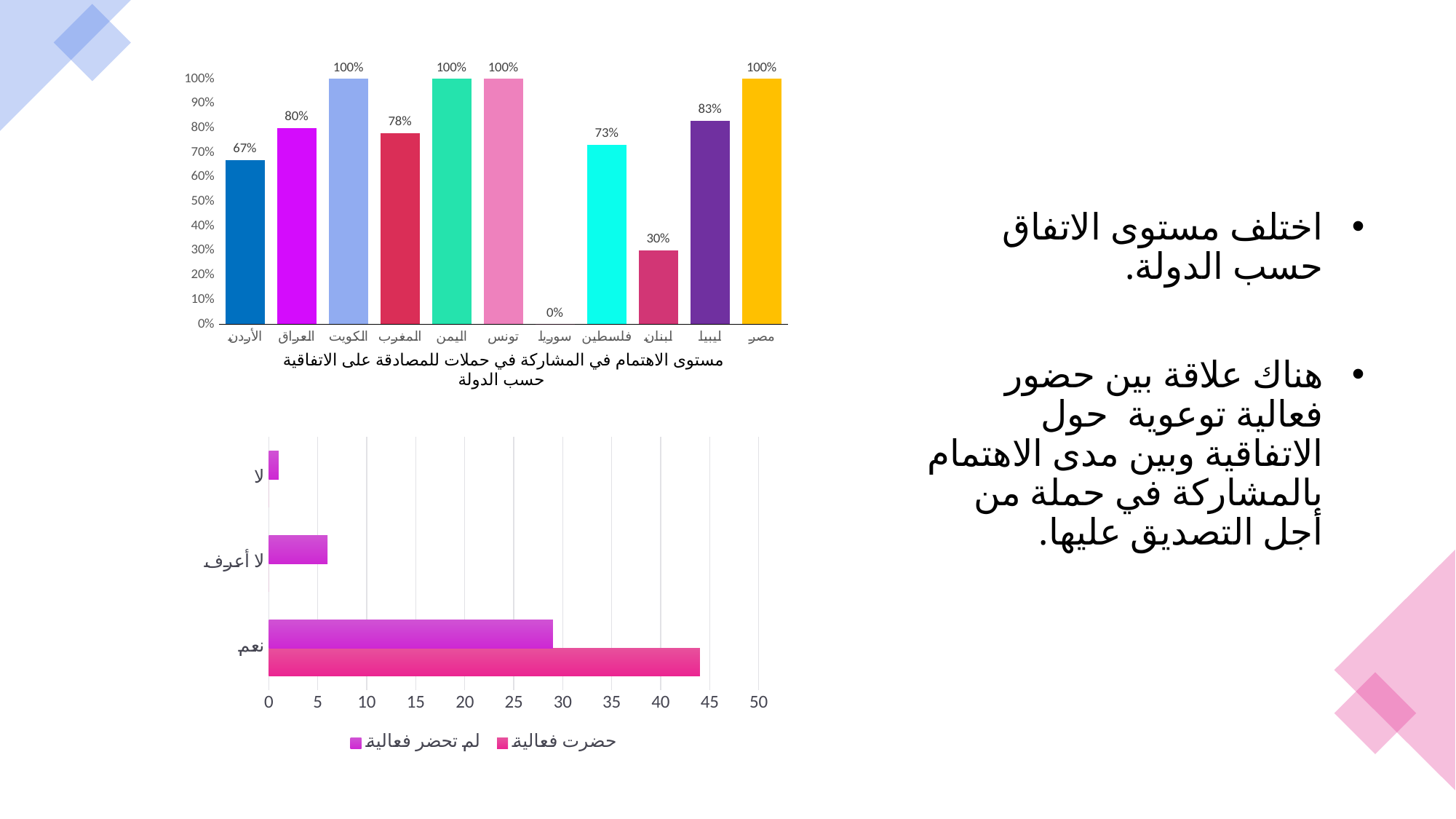
In the bottom chart, is the value of حضرت فعالية for نعم greater or less than 40? greater How many series does the legend of the bottom chart list? 2 In the top chart, what is the value for الأردن? 67% In the top chart, which country has the lowest value? سوريا In the top chart, what is the difference between the values for العراق and المغرب? 2% In the top chart, how many countries have a value of 100%? 4 In the bottom chart, is the value of لم تحضر فعالية for لا أعرف greater or less than 10? less In the top chart, what is the value for لبنان? 30% How many countries are shown on the x axis of the top chart? 11 In the top chart, which is larger, the value for فلسطين or the value for ليبيا? ليبيا In the top chart, what is the value for ليبيا? 83% What kind of chart is the bottom chart? Bar chart